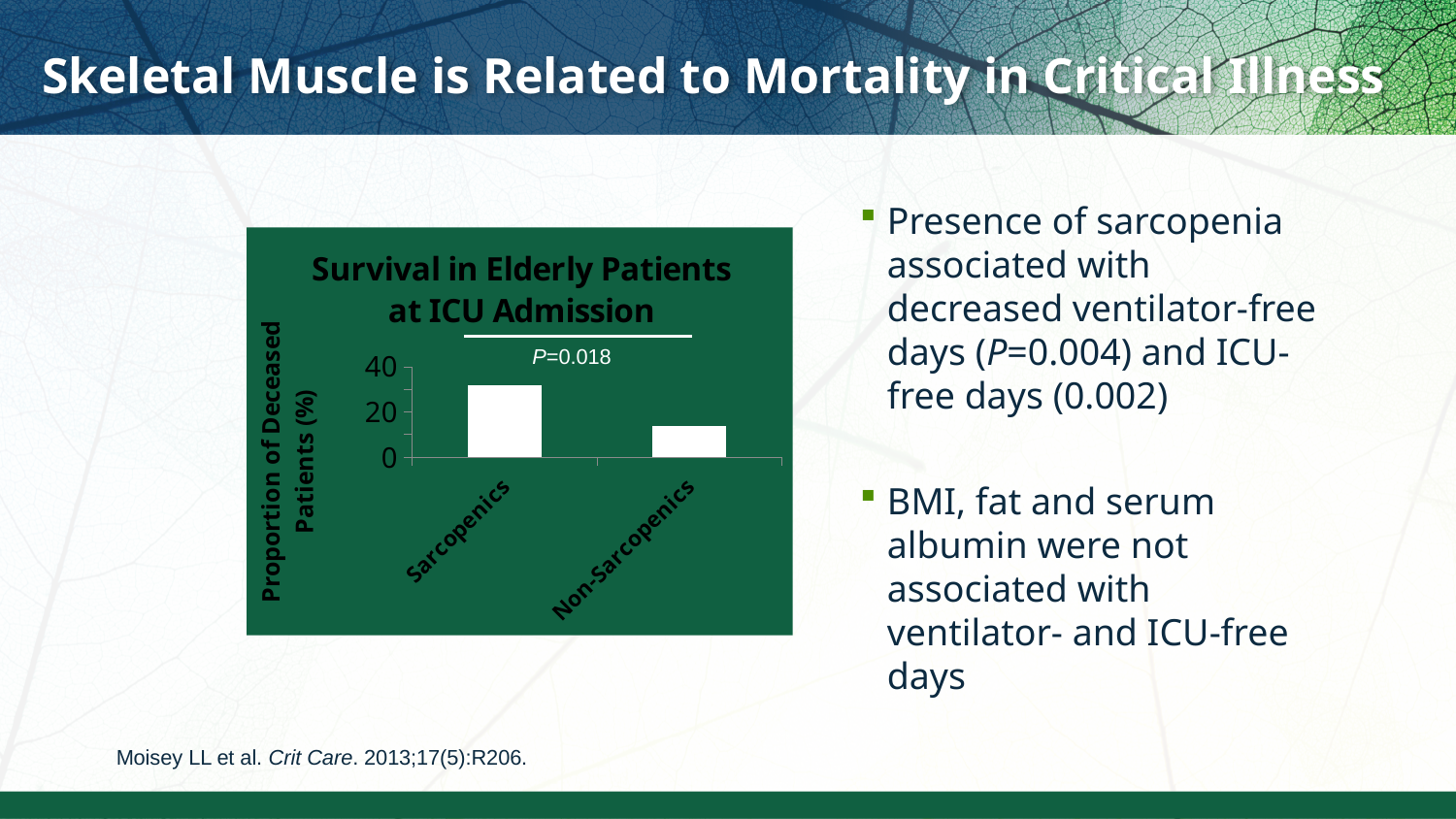
Is the value for Sarcopenics greater or less than 40? less What is the label of the chart's y axis? Proportion of Deceased Patients (%) What is the title of the chart? Survival in Elderly Patients at ICU Admission Which category has the lowest proportion of deceased patients? Non-Sarcopenics Which category has the highest proportion of deceased patients? Sarcopenics What kind of chart is shown on the slide? Bar chart Which group has a larger proportion of deceased patients, Sarcopenics or Non-Sarcopenics? Sarcopenics How many categories are plotted on the x axis of the chart? 2 Is the value for Sarcopenics greater or less than 20? greater Is the value for Non-Sarcopenics greater or less than 20? less